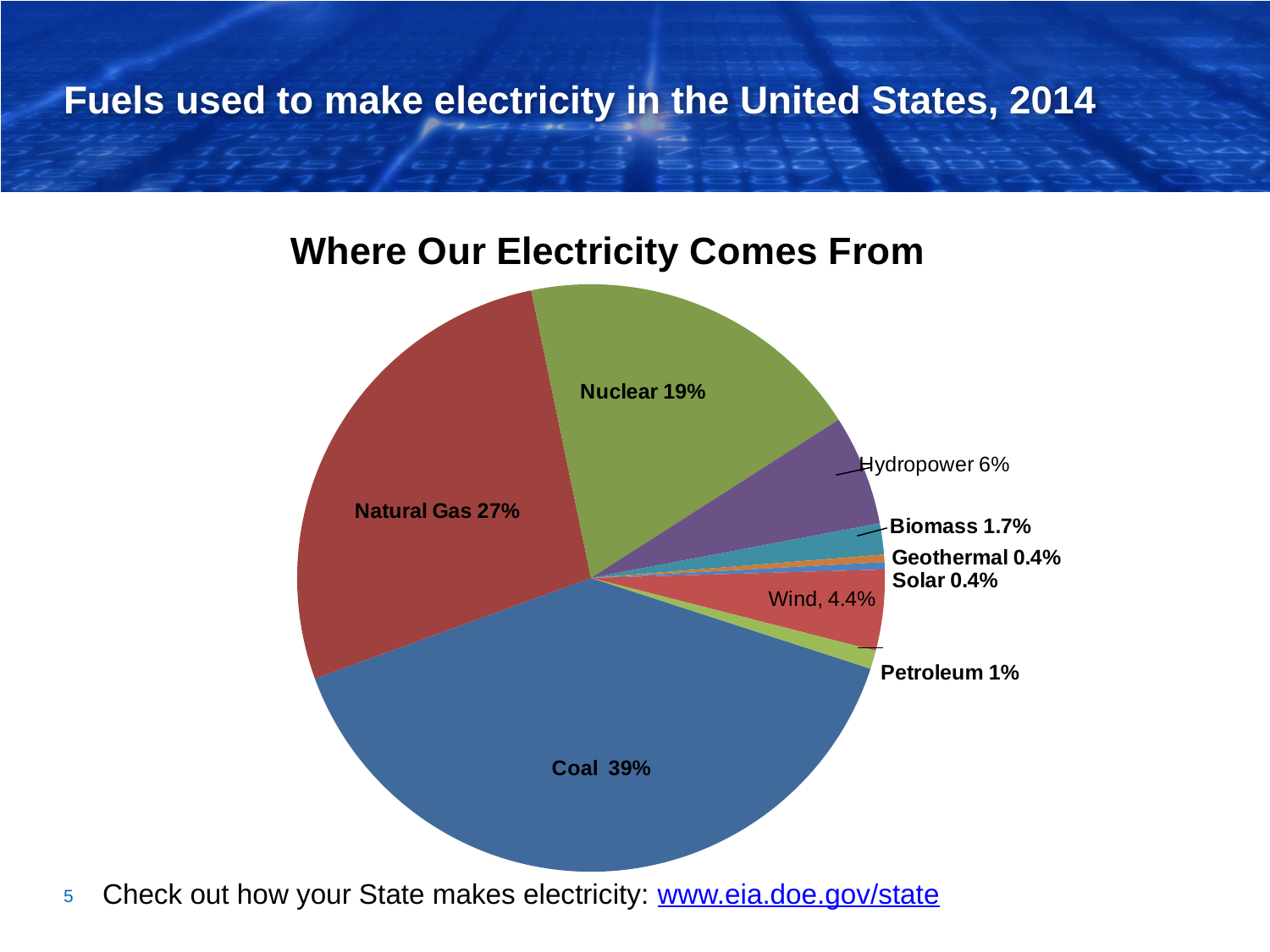
How many fuel categories are shown in the pie chart? 9 What share of electricity comes from Coal? 39% What is the difference in percentage points between Nuclear and Hydropower? 13 What share of electricity comes from Wind? 4.4% What share of electricity comes from Biomass? 1.7% What share of electricity comes from Nuclear? 19% What is the difference in percentage points between Coal and Natural Gas? 12 Which is larger, the share for Wind or the share for Hydropower? Hydropower What share of electricity comes from Natural Gas? 27% Which fuel has the largest share of the pie? Coal What type of chart is shown on the slide? Pie chart Which is larger, the share for Natural Gas or the share for Nuclear? Natural Gas